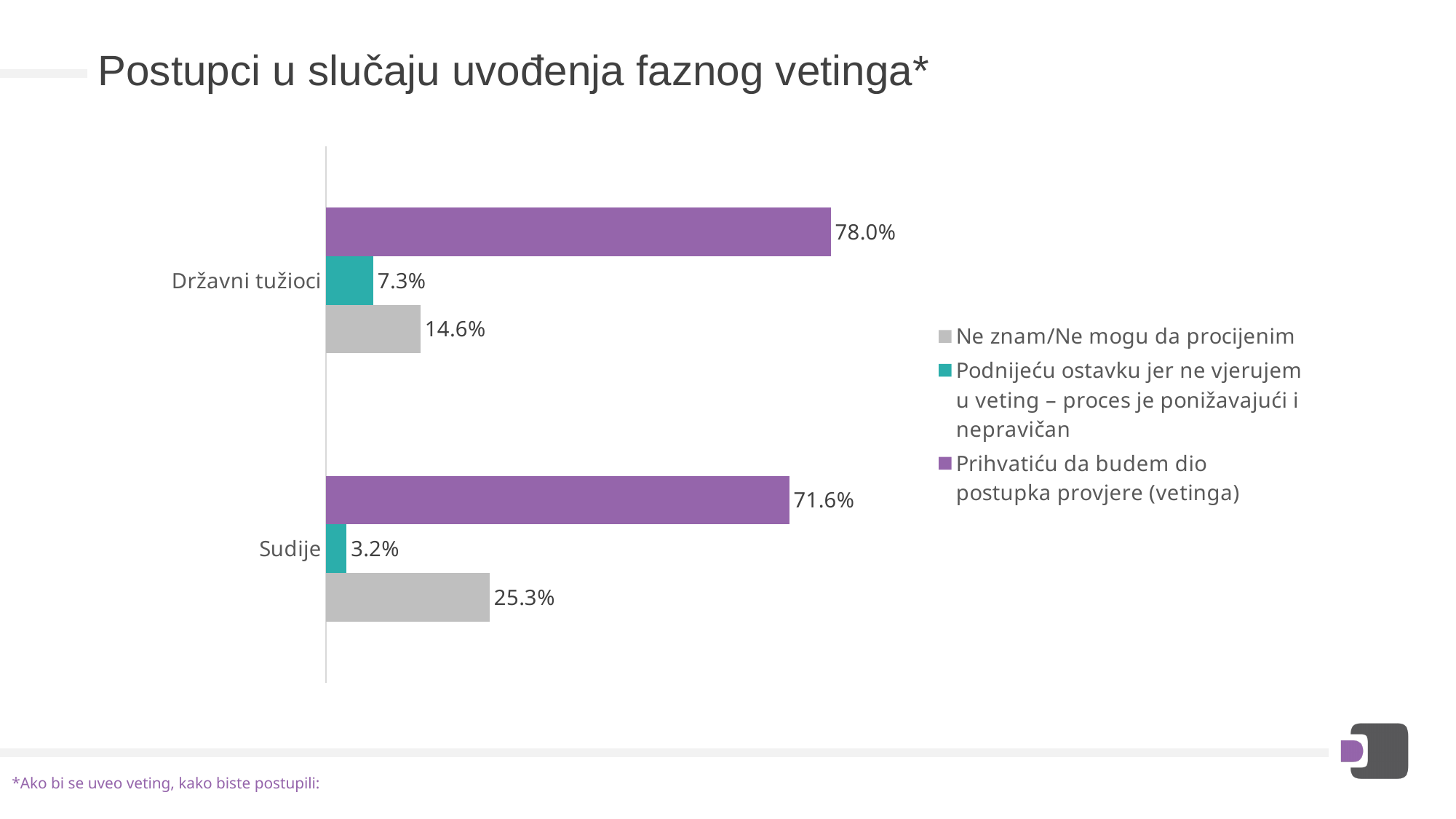
What is the difference between the "Ne znam/Ne mogu da procijenim" values for Sudije and Državni tužioci? 10.7% How many series does the legend list? 3 What type of chart is shown on the slide? Bar chart What is the difference between the "Prihvatiću da budem dio postupka provjere (vetinga)" values for Državni tužioci and Sudije? 6.4% Which category has the lower value for "Ne znam/Ne mogu da procijenim"? Državni tužioci What percentage of Sudije answered "Ne znam/Ne mogu da procijenim"? 25.3% Which category has the higher value for "Prihvatiću da budem dio postupka provjere (vetinga)"? Državni tužioci How many categories are shown on the chart? 2 What percentage of Državni tužioci said "Prihvatiću da budem dio postupka provjere (vetinga)"? 78.0% What is the value for Sudije in the series "Podnijeću ostavku jer ne vjerujem u veting – proces je ponižavajući i nepravičan"? 3.2% Which series has the lowest value for Sudije? Podnijeću ostavku jer ne vjerujem u veting – proces je ponižavajući i nepravičan What is the value for Državni tužioci in the "Ne znam/Ne mogu da procijenim" series? 14.6%